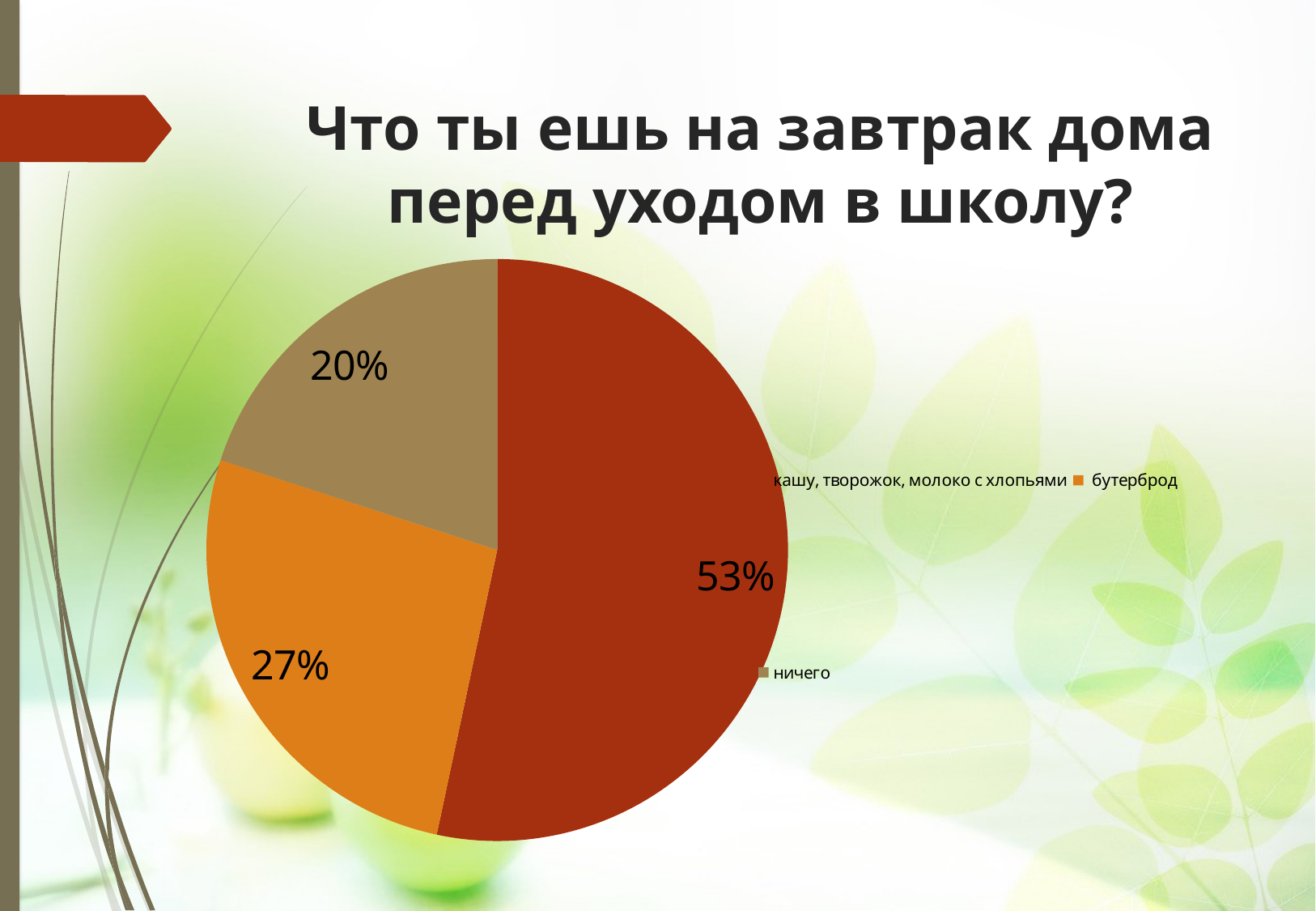
Which is larger, the slice for "бутерброд" or the slice for "ничего"? бутерброд What share of the pie does the slice for "ничего" have? 20% What share of the pie does the slice for "кашу, творожок, молоко с хлопьями" have? 53% Which category has the largest slice of the pie? кашу, творожок, молоко с хлопьями Which category has the smallest slice of the pie? ничего What is the difference in percentage points between the "бутерброд" slice and the "ничего" slice? 7% What kind of chart is shown on the slide? pie chart How many slices does the pie chart have? 3 What is the difference in percentage points between the "кашу, творожок, молоко с хлопьями" slice and the "бутерброд" slice? 26% What colour is the slice for "ничего"? tan (brownish-grey) What is the title of the chart on the slide? Что ты ешь на завтрак дома перед уходом в школу? What share of the pie does the slice for "бутерброд" have? 27%